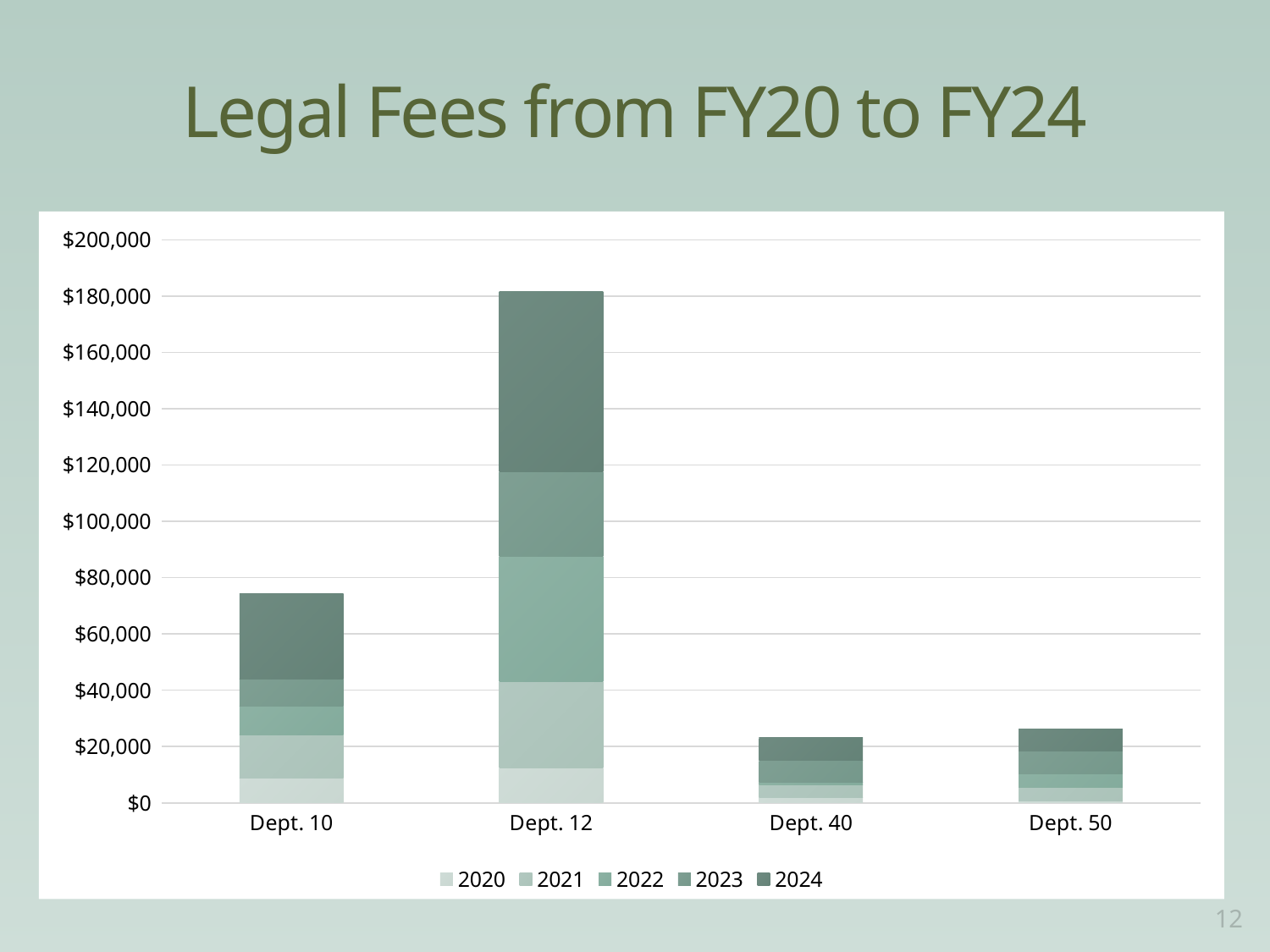
How many departments are shown on the x axis of the chart? 4 Which years are listed in the chart's legend? 2020, 2021, 2022, 2023, 2024 Is the total value for Dept. 12 greater or less than $160,000? greater Which has a larger total of legal fees, Dept. 10 or Dept. 12? Dept. 12 What kind of chart is shown on the slide? Stacked bar chart Is the total value for Dept. 10 greater or less than $60,000? greater Which has a larger total of legal fees, Dept. 10 or Dept. 40? Dept. 10 Which department has the highest total legal fees? Dept. 12 How many series does the legend list? 5 Is the total value for Dept. 10 greater or less than $80,000? less What is the title of the chart on the slide? Legal Fees from FY20 to FY24